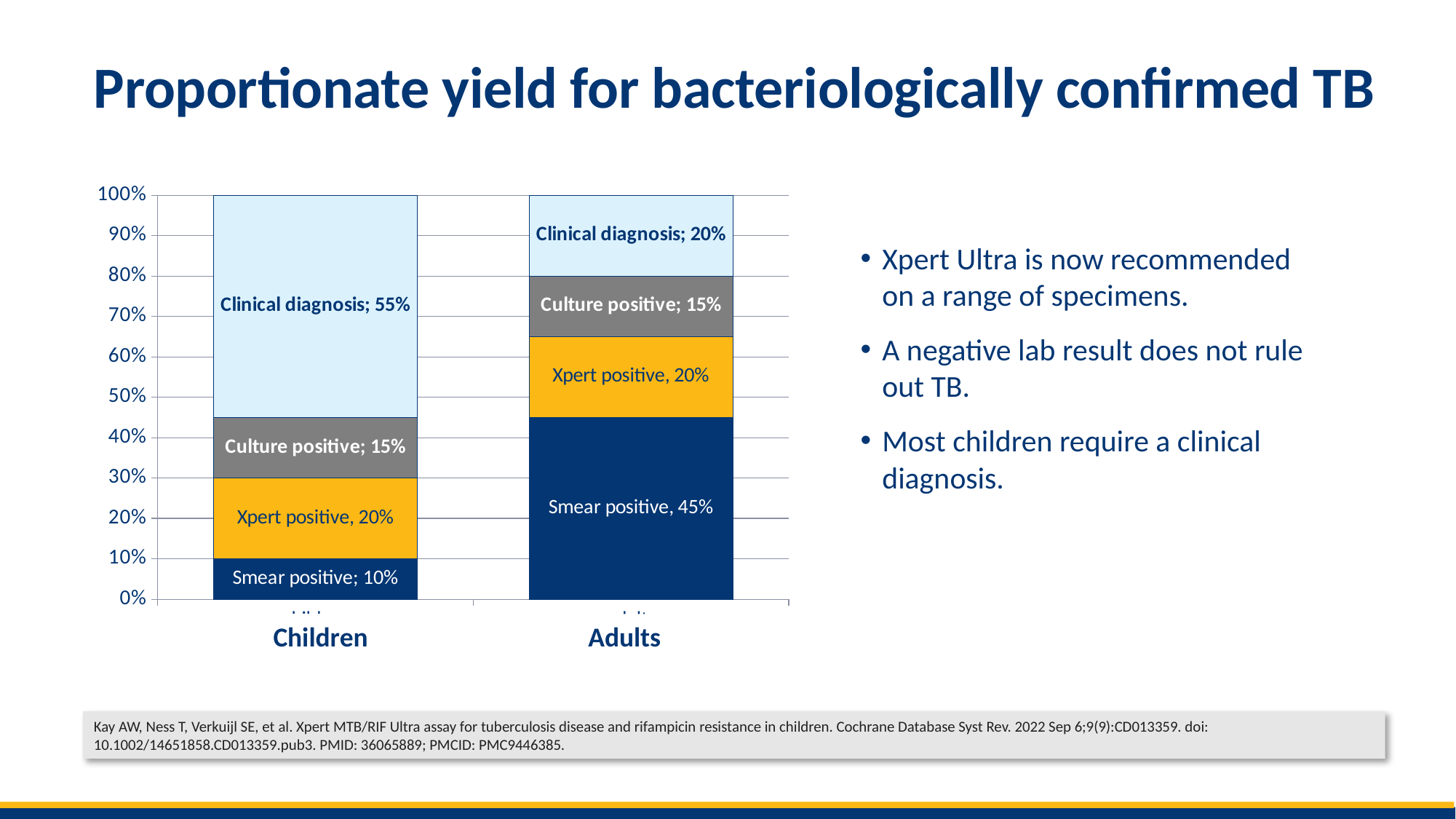
What kind of chart is shown on the slide? Stacked bar chart How many categories are shown on the x axis? 2 What is the Culture positive value for Children? 15% Which segment is the smallest in the Children bar? Smear positive What is the title of the slide containing the chart? Proportionate yield for bacteriologically confirmed TB What is the Smear positive value for Children? 10% What is the total of the stacked bar for Adults? 100% Which segment is the largest in the Children bar? Clinical diagnosis What is the Smear positive value for Adults? 45% What is the difference between the Clinical diagnosis value for Children and for Adults? 35% Which is larger: the Smear positive value for Adults or for Children? Adults What is the Clinical diagnosis value for Adults? 20%